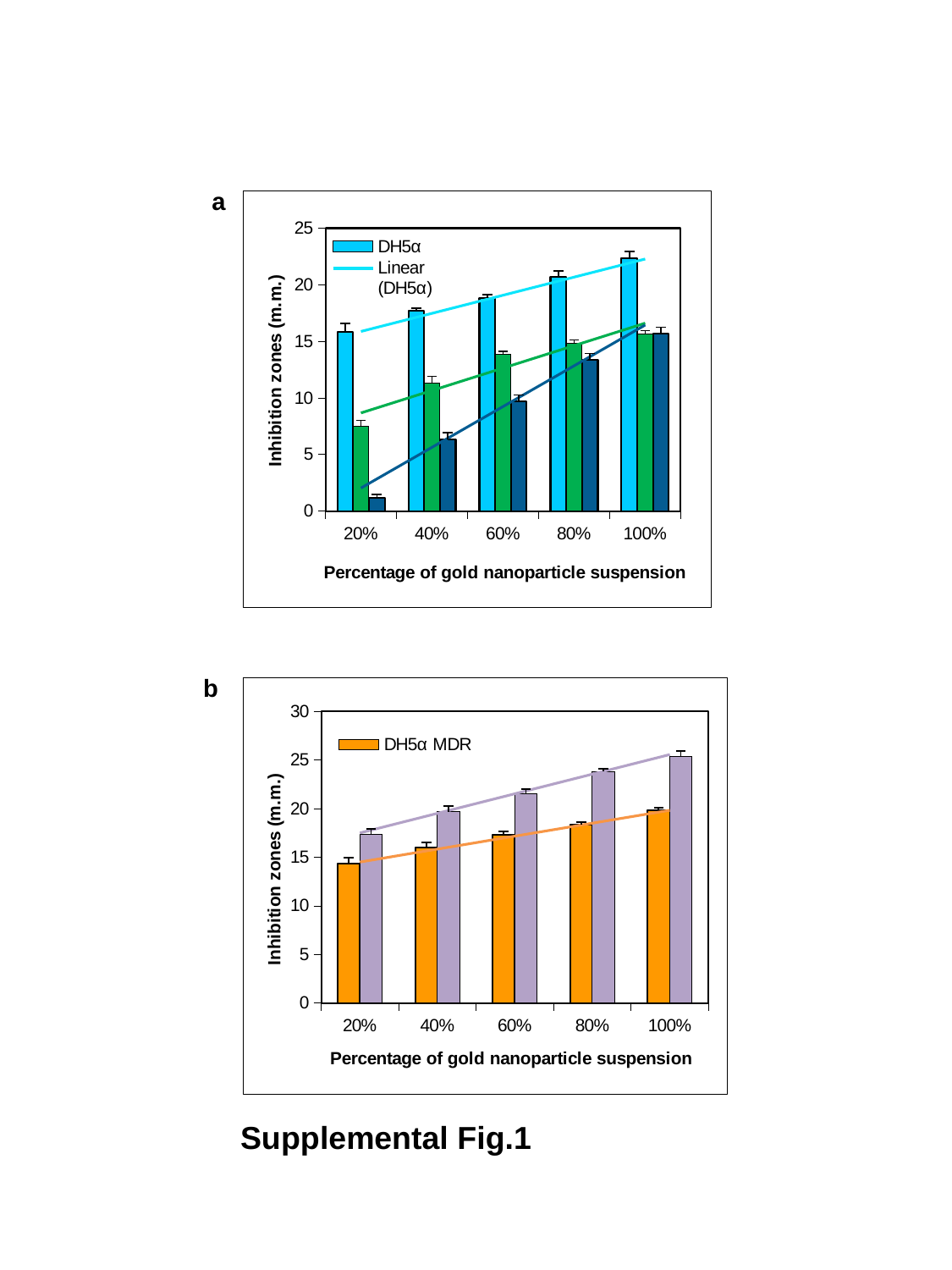
In chart a (the top chart), is the DH5α inhibition zone at 20% greater or less than 20? less In chart b (the bottom chart), is the DH5α MDR inhibition zone at 20% greater or less than 15? less In chart a (the top chart), do the DH5α inhibition zones rise or fall as the percentage of gold nanoparticle suspension increases? rise In chart b (the bottom chart), which is larger for DH5α MDR: the inhibition zone at 20% or at 100%? 100% In chart a (the top chart), is the DH5α inhibition zone at 100% greater or less than 20? greater In chart a (the top chart), at which percentage of gold nanoparticle suspension is the DH5α inhibition zone highest? 100% What kind of chart is chart a (the top chart)? bar chart What is the label of the series shown in the legend of chart b (the bottom chart)? DH5α MDR How many entries does the legend of chart a (the top chart) list? 2 In chart a (the top chart), at which percentage of gold nanoparticle suspension is the DH5α inhibition zone lowest? 20% How many percentage categories are shown on the x axis of chart b (the bottom chart)? 5 What is the y-axis label of chart b (the bottom chart)? Inhibition zones (m.m.)